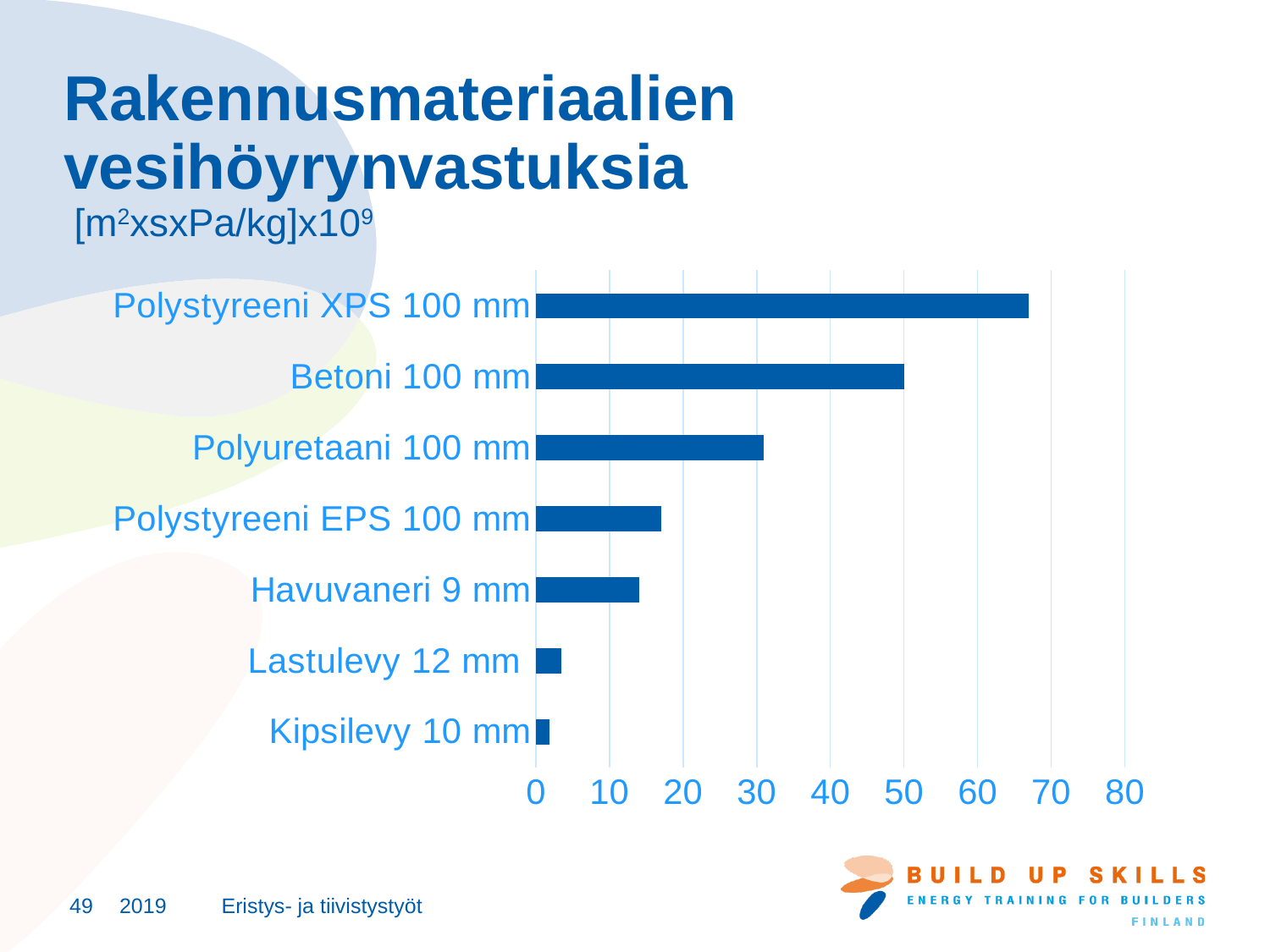
Is the value for Polystyreeni XPS 100 mm greater or less than 60? greater Which has the larger value, Polyuretaani 100 mm or Polystyreeni EPS 100 mm? Polyuretaani 100 mm Which material has the lowest value in the chart? Kipsilevy 10 mm What kind of chart is shown on the slide? bar chart What is the highest tick value shown on the horizontal axis of the chart? 80 Is the value for Polystyreeni EPS 100 mm greater or less than 20? less Is the value for Polyuretaani 100 mm greater or less than 20? greater How many materials (categories) are plotted in the chart? 7 Which has the larger value, Polystyreeni XPS 100 mm or Betoni 100 mm? Polystyreeni XPS 100 mm Which material has the highest value in the chart? Polystyreeni XPS 100 mm